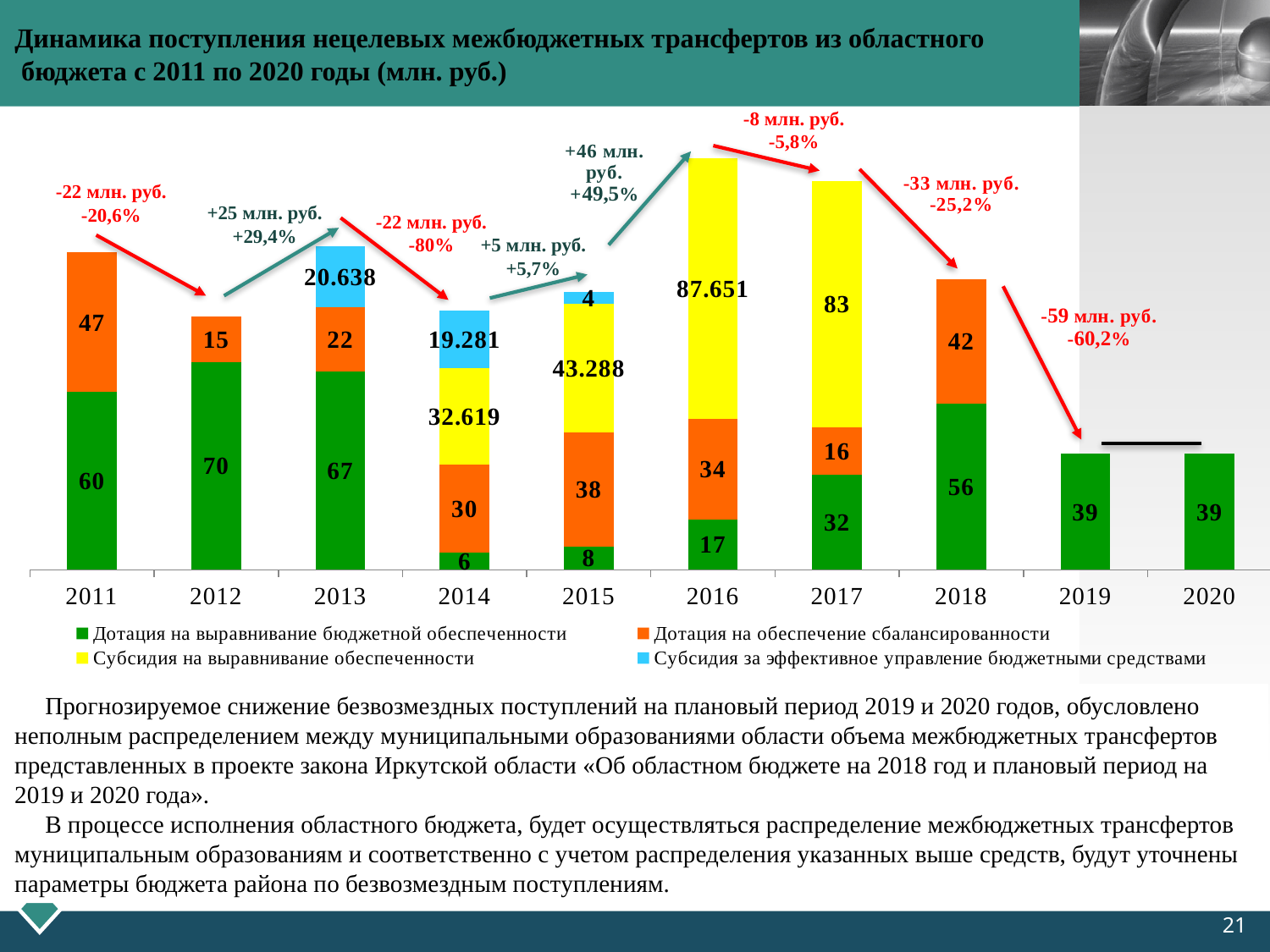
What is the value of the green series (Дотация на выравнивание бюджетной обеспеченности) for 2012? 70 In which year is the green series (Дотация на выравнивание бюджетной обеспеченности) lowest? 2014 What is the value of the blue series (Субсидия за эффективное управление бюджетными средствами) for 2013? 20.638 What is the value of the yellow series (Субсидия на выравнивание обеспеченности) for 2016? 87.651 What is the total of the stacked bar for 2018? 98 How many years are shown on the x axis? 10 Which series is shown in yellow according to the legend? Субсидия на выравнивание обеспеченности What kind of chart is shown on the slide? Stacked bar chart Which is larger: the yellow series value for 2016 or for 2017? 2016 In which year is the green series (Дотация на выравнивание бюджетной обеспеченности) highest? 2012 What is the difference between the orange series values for 2011 and 2012? 32 How many series does the legend list? 4